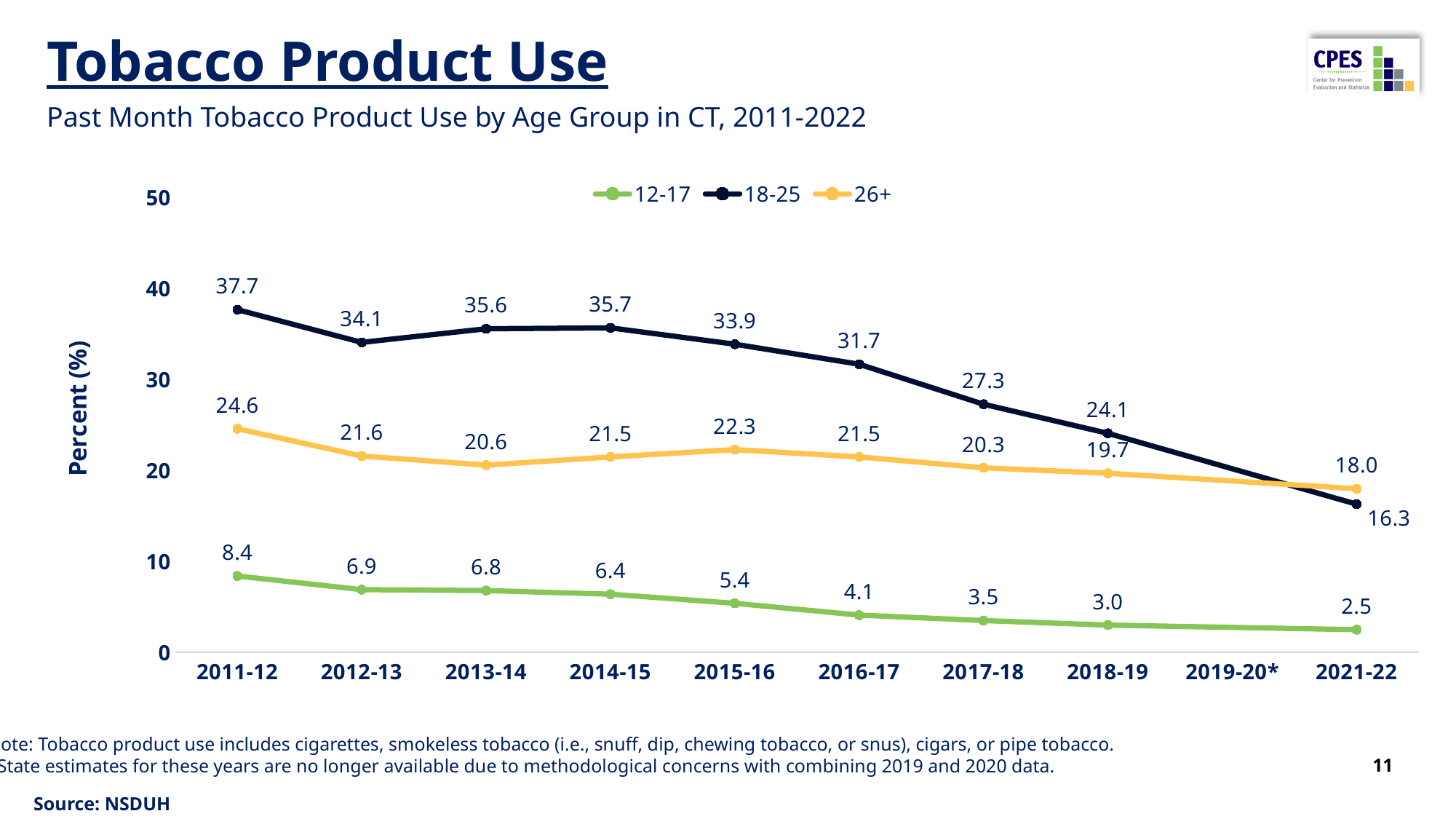
What was the value for the 26+ age group in 2015-16? 22.3 What is the difference between the 18-25 and 26+ values in 2018-19? 4.4 In which year did the 26+ age group have its highest value? 2011-12 In which year did the 18-25 age group have its lowest value? 2021-22 What was the past month tobacco product use percentage for the 18-25 age group in 2011-12? 37.7 How many time periods are labeled on the x axis? 10 In 2021-22, which age group had the higher value: 18-25 or 26+? 26+ Which age group is shown with the green line? 12-17 What was the value for the 12-17 age group in 2021-22? 2.5 How many age groups does the legend list? 3 What type of chart is shown on the slide? Line chart Does the 12-17 age group's value rise or fall from 2011-12 to 2021-22? Fall